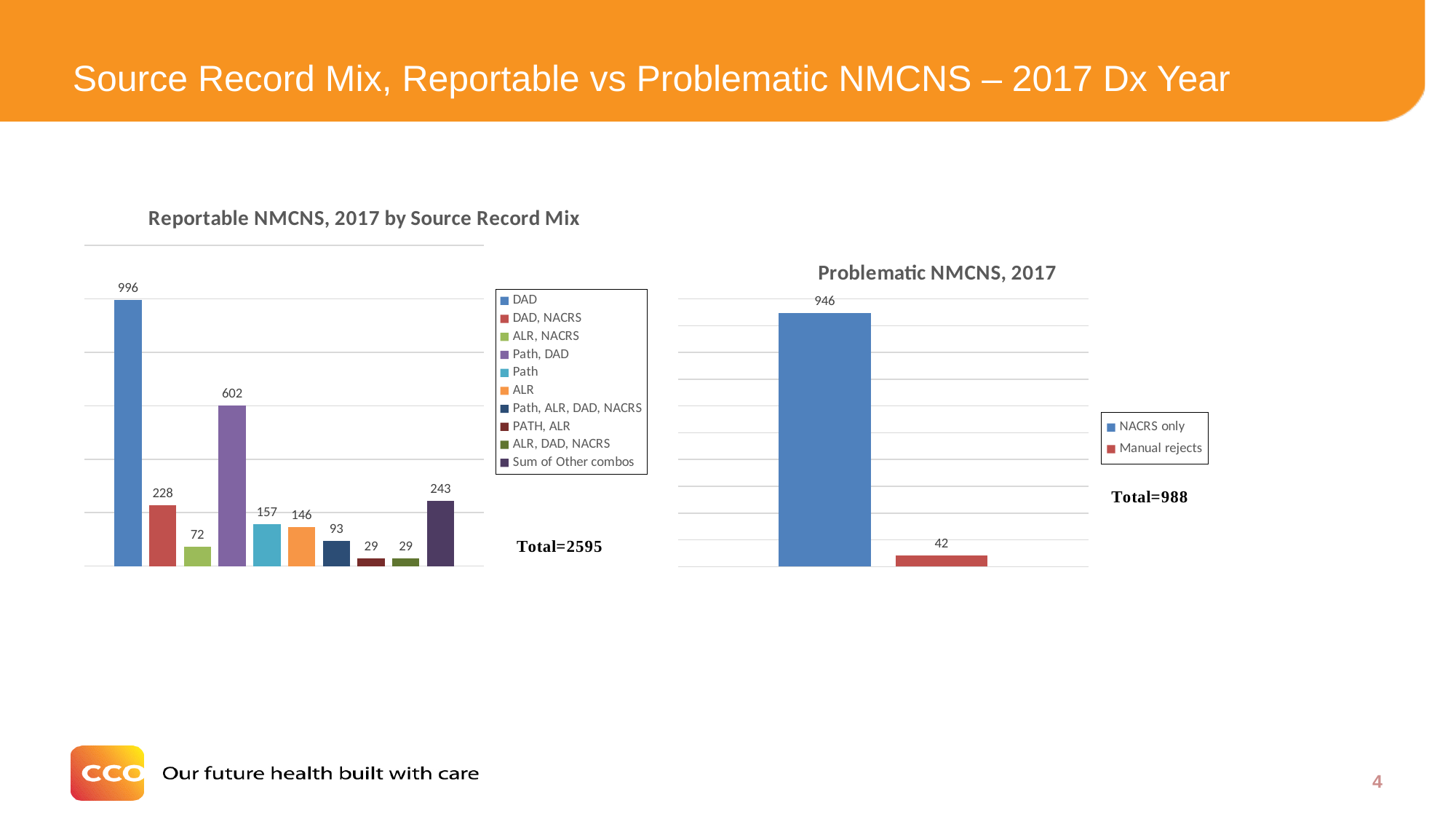
In the 'Reportable NMCNS, 2017 by Source Record Mix' chart, which is larger, the value for Path or the value for ALR? Path In the 'Problematic NMCNS, 2017' chart, what is the value for Manual rejects? 42 How many bars are plotted in the 'Reportable NMCNS, 2017 by Source Record Mix' chart? 10 In the 'Reportable NMCNS, 2017 by Source Record Mix' chart, what is the difference between the DAD value and the Path, DAD value? 394 In the 'Reportable NMCNS, 2017 by Source Record Mix' chart, what is the value for Sum of Other combos? 243 In the 'Problematic NMCNS, 2017' chart, what is the difference between NACRS only and Manual rejects? 904 What type of chart is the 'Problematic NMCNS, 2017' chart? Bar chart In the 'Problematic NMCNS, 2017' chart, what is the value for NACRS only? 946 In the 'Reportable NMCNS, 2017 by Source Record Mix' chart, what is the value for DAD? 996 In the 'Reportable NMCNS, 2017 by Source Record Mix' chart, which category has the highest value? DAD In the 'Reportable NMCNS, 2017 by Source Record Mix' chart, what is the value for Path, DAD? 602 How many entries does the legend of the 'Reportable NMCNS, 2017 by Source Record Mix' chart list? 10